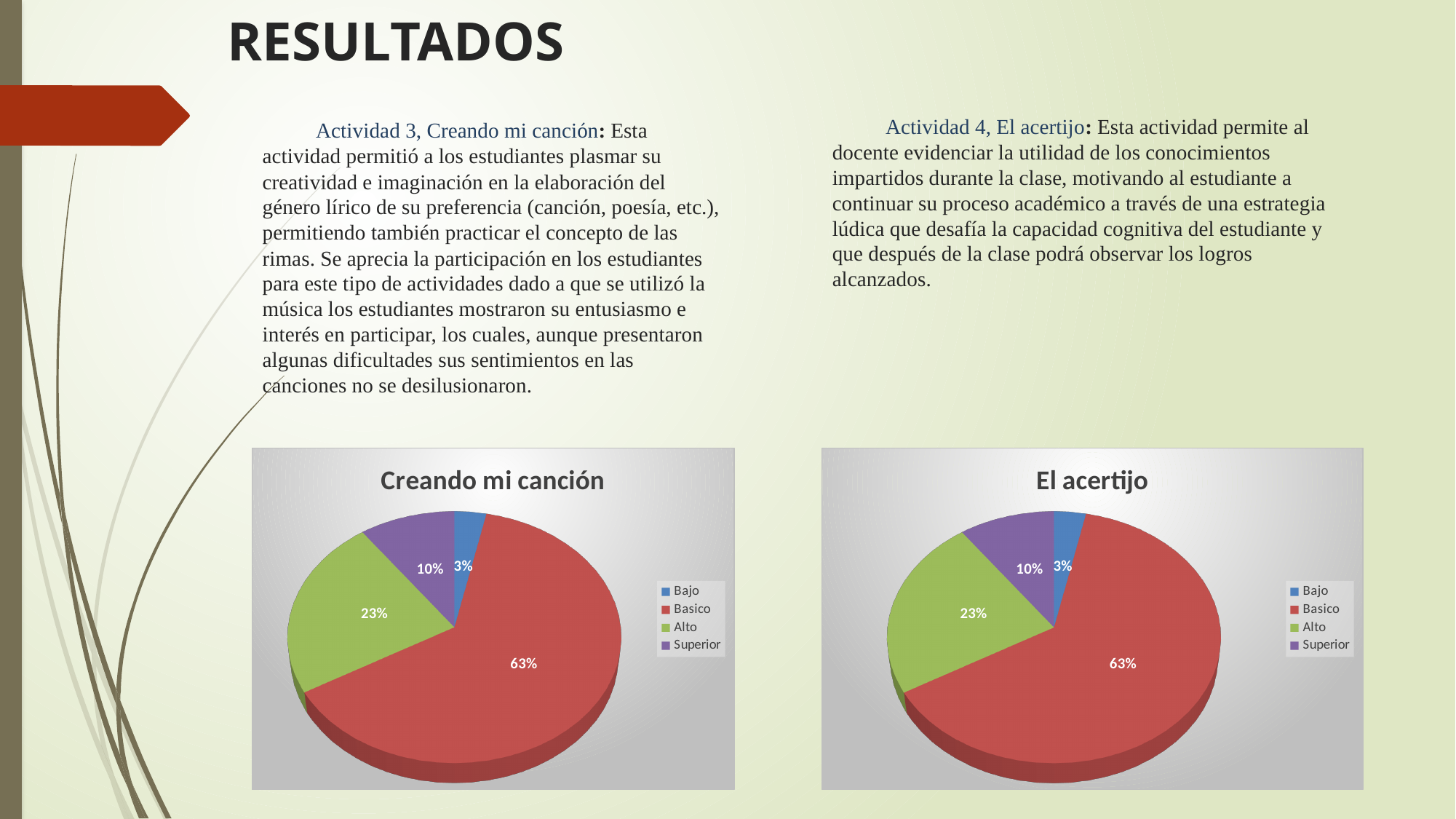
In the 'Creando mi canción' chart, what share does Superior have? 10% In the 'Creando mi canción' chart, which category has the largest slice? Basico In the 'El acertijo' chart, which is larger, Alto or Superior? Alto In the 'El acertijo' chart, which category has the smallest slice? Bajo In the 'El acertijo' chart, what share does Bajo have? 3% In the 'Creando mi canción' chart, what share does Basico have? 63% In the 'El acertijo' chart, what share does Alto have? 23% What kind of chart is 'Creando mi canción'? Pie chart In the 'El acertijo' chart, what is the combined share of Bajo and Superior? 13% How many categories does the 'El acertijo' chart show? 4 In the 'Creando mi canción' chart, what colour is the Alto slice? Green In the 'Creando mi canción' chart, what is the difference between the Basico and Alto shares? 40%